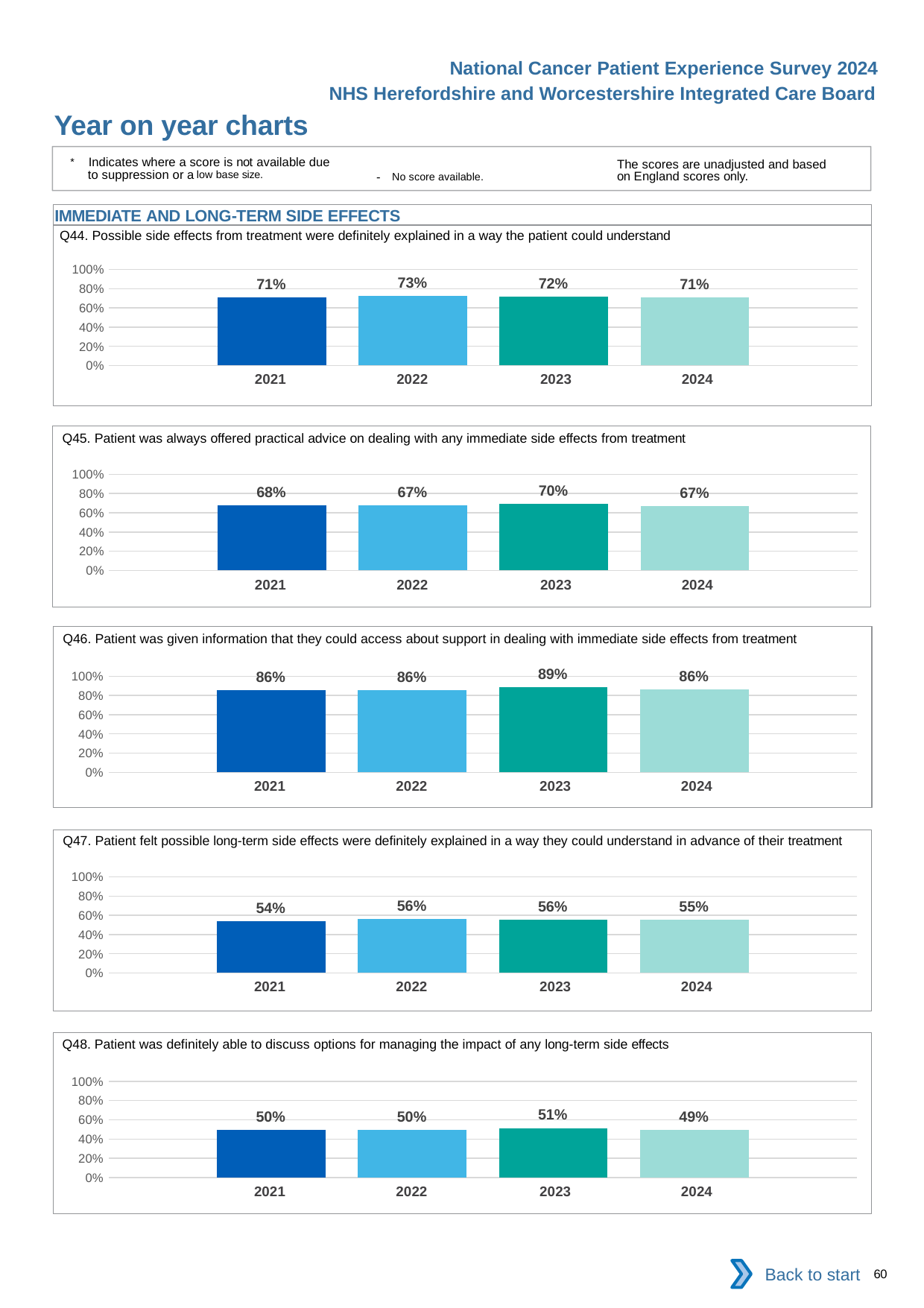
In the Q47 chart, which is larger, the value for 2021 or the value for 2022? 2022 What kind of chart is used for Q46? Bar chart In the Q44 chart, what is the value for 2022? 73% In the Q44 chart, what is the difference between the 2022 value and the 2021 value? 2% How many bars are plotted in the Q45 chart? 4 In the Q46 chart, what is the difference between the 2023 value and the 2024 value? 3% In the Q45 chart, which year has the highest value? 2023 In the Q45 chart, what is the value for 2024? 67% How many charts are shown on the slide? 5 In the Q47 chart, is the value for 2021 greater or less than 60%? less In the Q48 chart, which year has the lowest value? 2024 In the Q48 chart, what is the value for 2023? 51%